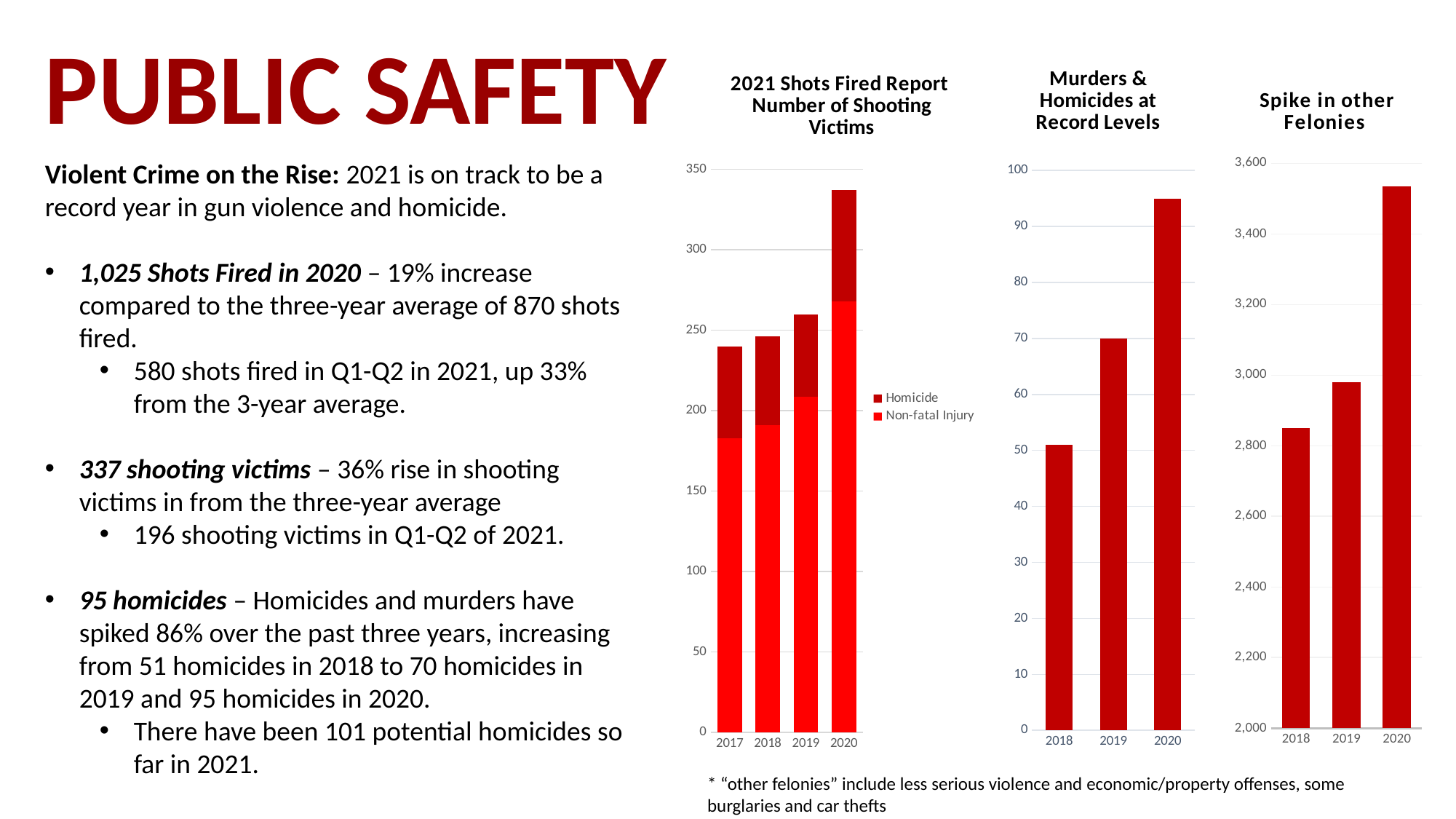
How many years are shown on the x axis of the '2021 Shots Fired Report Number of Shooting Victims' chart? 4 In the '2021 Shots Fired Report Number of Shooting Victims' chart, which year has the tallest stacked bar? 2020 How many bars are in the 'Spike in other Felonies' chart? 3 In the '2021 Shots Fired Report Number of Shooting Victims' chart, is the total for 2020 greater or less than 300? greater In the 'Murders & Homicides at Record Levels' chart, which year has the highest value? 2020 In the 'Murders & Homicides at Record Levels' chart, what is the value for 2019? 70 In the '2021 Shots Fired Report Number of Shooting Victims' chart, do the total bar heights rise or fall from 2017 to 2020? rise What are the legend entries in the '2021 Shots Fired Report Number of Shooting Victims' chart? Homicide, Non-fatal Injury How many series does the legend of the '2021 Shots Fired Report Number of Shooting Victims' chart list? 2 What kind of chart is the '2021 Shots Fired Report Number of Shooting Victims' chart? bar chart In the 'Murders & Homicides at Record Levels' chart, is the value for 2018 greater or less than 60? less In the 'Spike in other Felonies' chart, is the value for 2020 greater or less than 3,400? greater